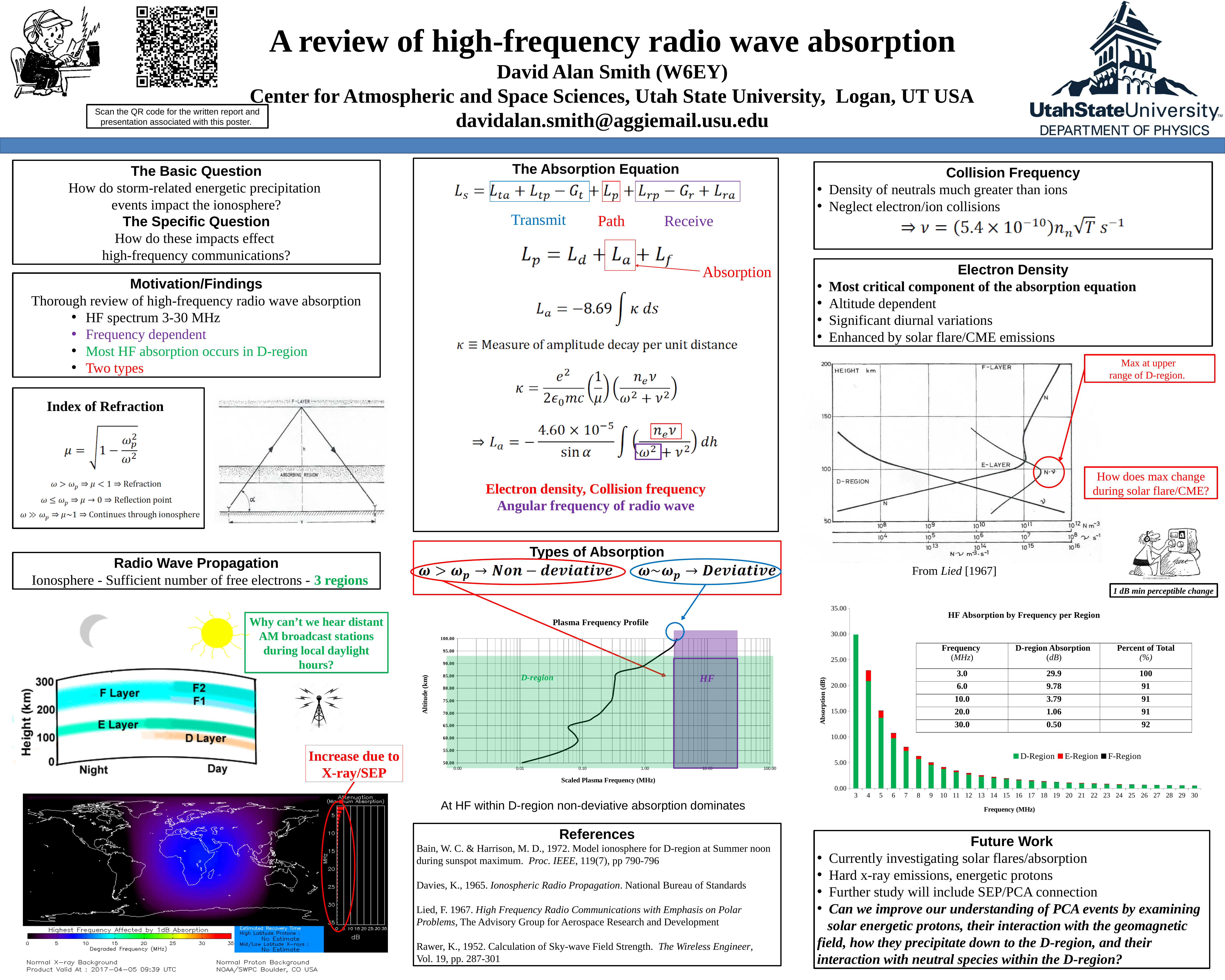
In the 'HF Absorption by Frequency per Region' chart, what kind of chart is used to show absorption? bar chart In the 'HF Absorption by Frequency per Region' chart, how many series does the legend list? 3 In the 'HF Absorption by Frequency per Region' chart, how many frequency categories are shown on the x axis? 28 In the 'Plasma Frequency Profile' chart, what kind of chart is shown? line chart In the 'HF Absorption by Frequency per Region' chart, is the total absorption at 10 MHz greater or less than 5.00 dB? less In the 'HF Absorption by Frequency per Region' chart, is the total absorption at 4 MHz greater or less than 20.00 dB? greater In the 'HF Absorption by Frequency per Region' chart, which frequency has the highest total absorption? 3 In the 'HF Absorption by Frequency per Region' chart, what is the label of the x axis? Frequency (MHz) In the 'HF Absorption by Frequency per Region' chart, do the absorption values rise or fall as frequency increases along the x axis? fall According to the table in the 'HF Absorption by Frequency per Region' chart, what is the D-region absorption at 6.0 MHz? 9.78 According to the table in the 'HF Absorption by Frequency per Region' chart, what is the difference between the D-region absorption at 3.0 MHz and at 10.0 MHz? 26.11 In the 'HF Absorption by Frequency per Region' chart, what are the three legend entries? D-Region, E-Region, F-Region